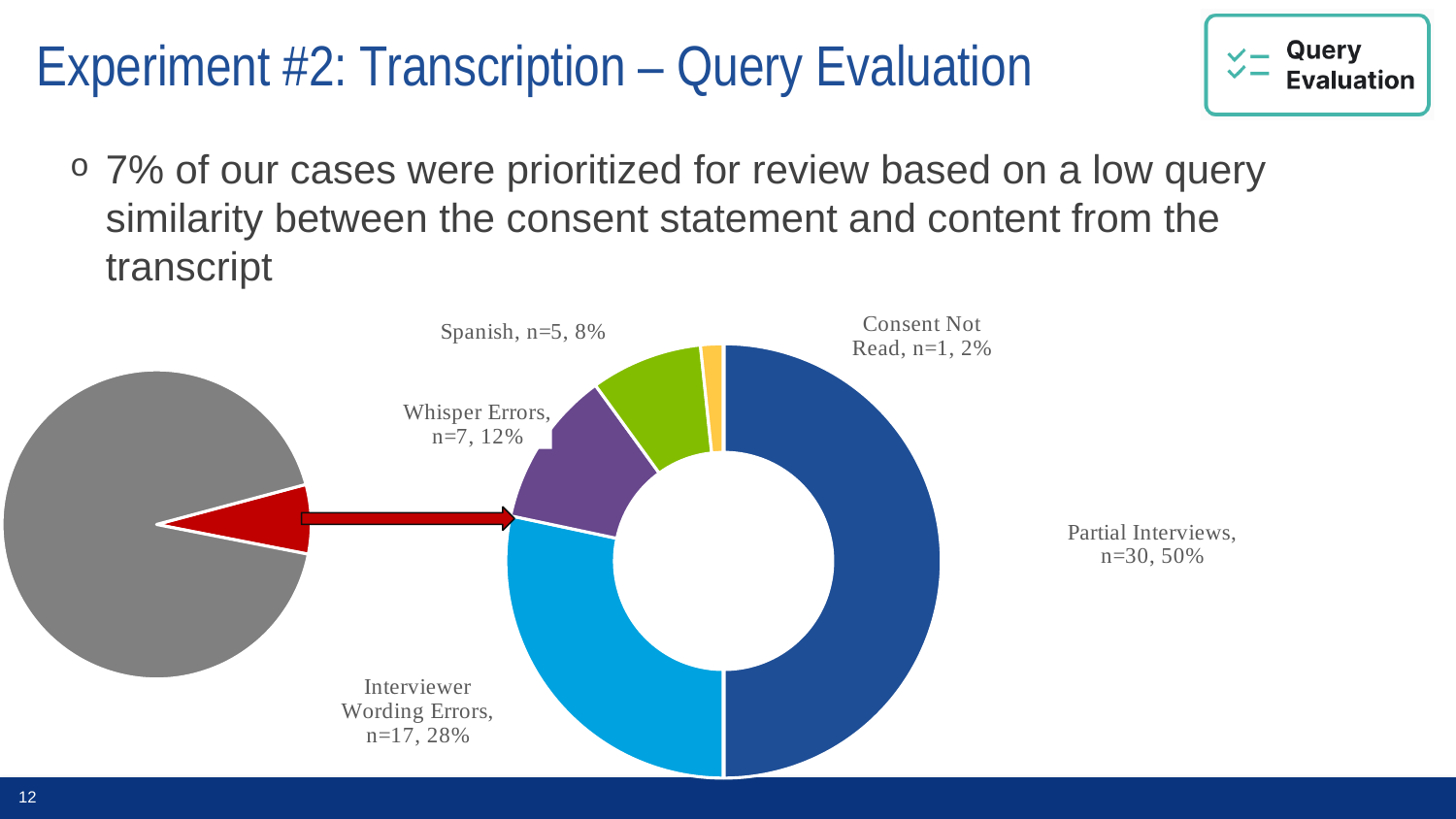
What kind of chart is the grey and red chart on the left side of the slide? Pie chart In the doughnut chart on the right, how many categories are shown? 5 In the doughnut chart on the right, which category has the smallest share? Consent Not Read In the doughnut chart on the right, which category has the largest share? Partial Interviews In the doughnut chart on the right, what is the count (n) for Whisper Errors? n=7 In the doughnut chart on the right, how many more cases are Partial Interviews than Interviewer Wording Errors? 13 What kind of chart is the chart on the right side of the slide? Doughnut chart In the doughnut chart on the right, which has more cases: Whisper Errors or Spanish? Whisper Errors In the doughnut chart on the right, what percentage share do Interviewer Wording Errors have? 28% In the doughnut chart on the right, what colour is the Partial Interviews segment? Dark blue In the doughnut chart on the right, what is the count (n) for Partial Interviews? n=30 In the doughnut chart on the right, what percentage share does Spanish have? 8%